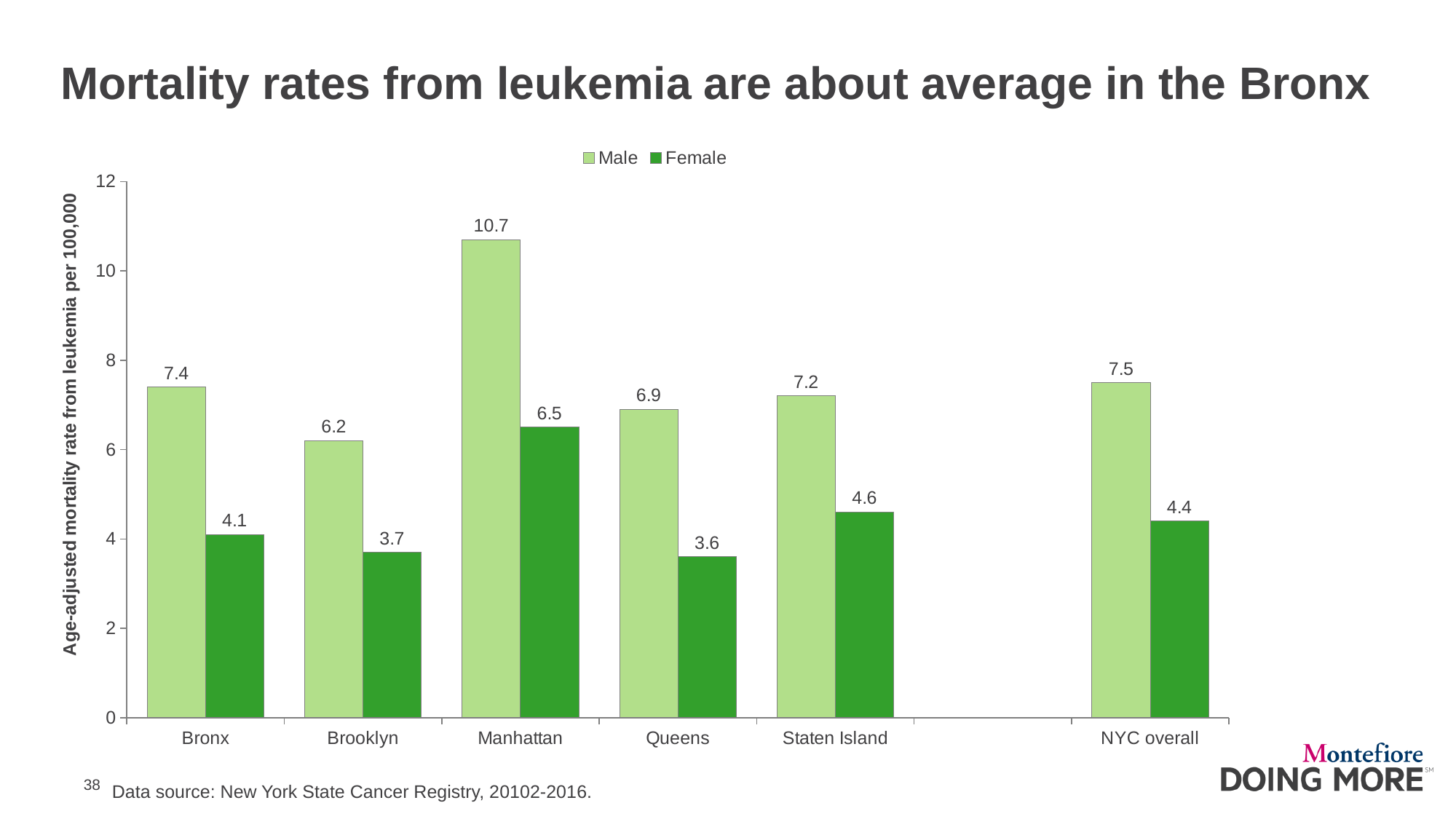
Which borough has the lowest female mortality rate from leukemia? Queens Which is larger, the male mortality rate in Brooklyn or in Queens? Queens What is the difference between the male and female mortality rates in Staten Island? 2.6 What is the title of the slide? Mortality rates from leukemia are about average in the Bronx What is the male mortality rate from leukemia in the Bronx? 7.4 What is the female mortality rate from leukemia in Manhattan? 6.5 How many series does the legend list? 2 Which borough has the highest male mortality rate from leukemia? Manhattan How many categories are shown on the x axis? 6 What kind of chart is shown on the slide? Bar chart What is the female mortality rate from leukemia for NYC overall? 4.4 What is the label of the y axis? Age-adjusted mortality rate from leukemia per 100,000